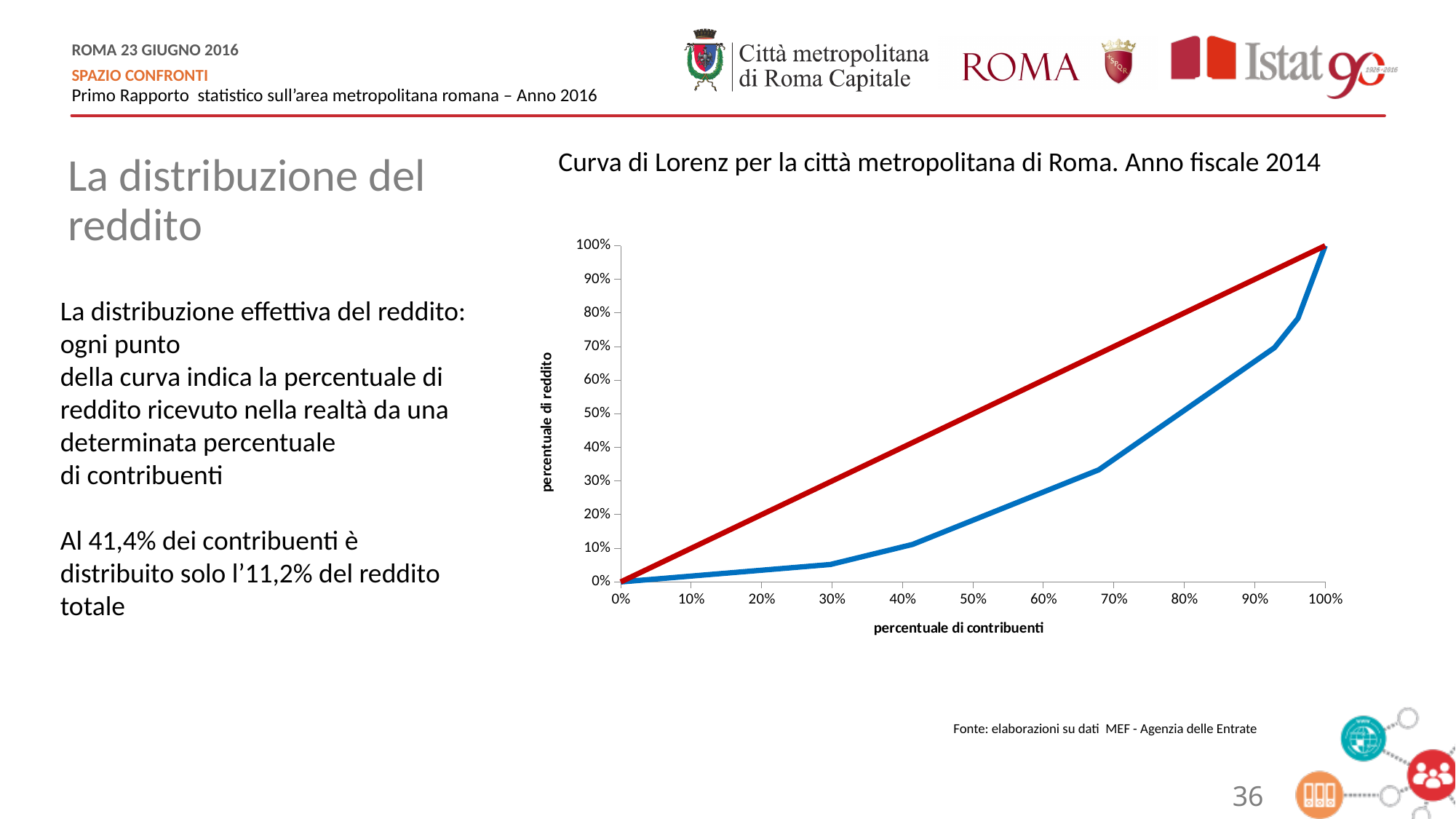
At 30% of contributors, is the value of the blue curve greater or less than 10%? less What value does the blue curve reach at 100% of contributors? 100% What value does the blue curve have at 0% of contributors? 0% How many lines are plotted on the chart? 2 Does the blue curve rise or fall as the percentage of contributors increases? rise At 50% of contributors, which line has the higher value, the red line or the blue line? the red line What kind of chart is shown on the slide? line chart At 50% of contributors, is the value of the red line greater or less than 40%? greater At 70% of contributors, is the value of the blue curve greater or less than 40%? less What is the label of the horizontal axis of the chart? percentuale di contribuenti What is the title of the chart? Curva di Lorenz per la città metropolitana di Roma. Anno fiscale 2014